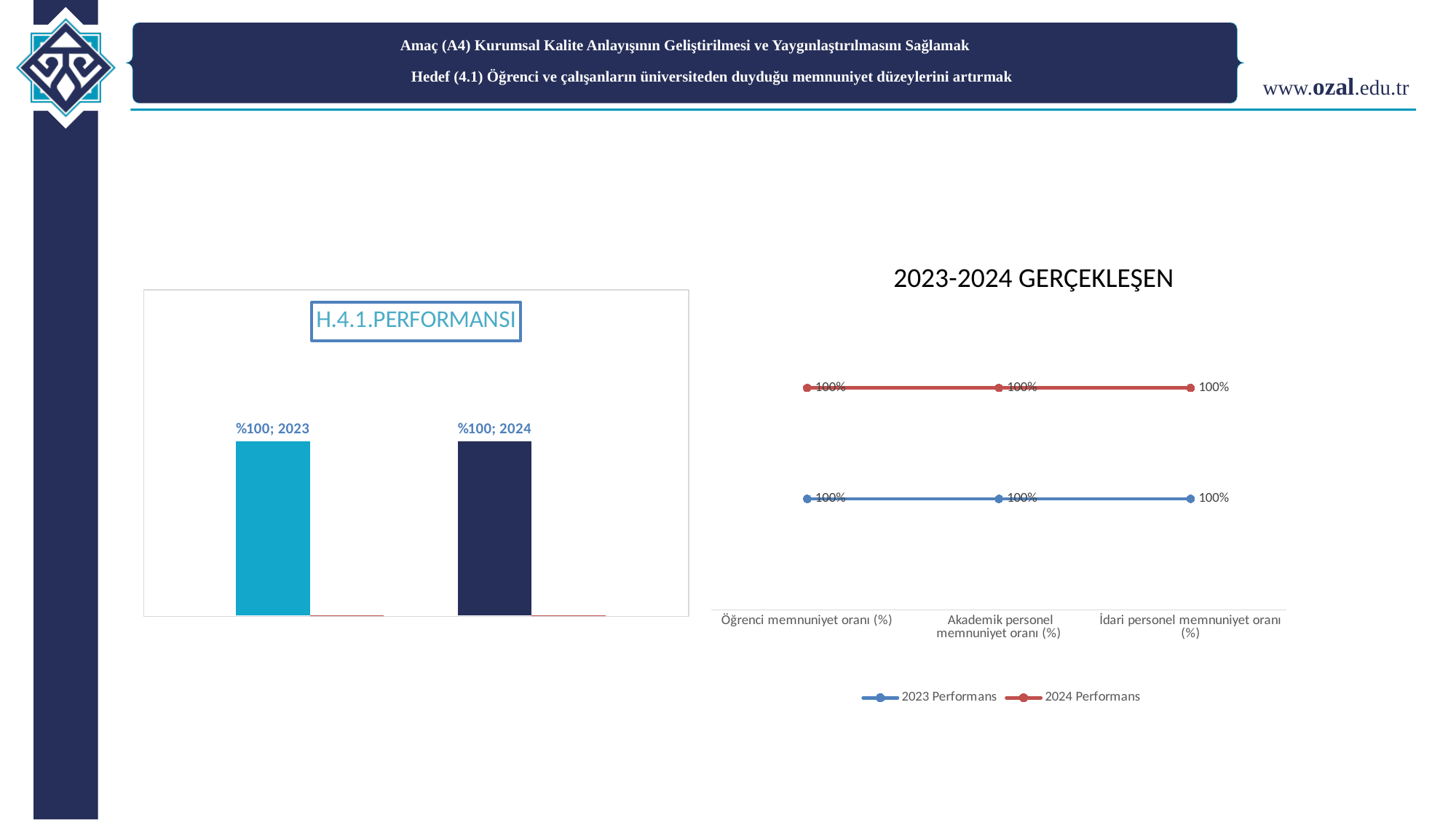
How many categories are shown on the x axis of the 2023-2024 GERÇEKLEŞEN chart? 3 In the H.4.1.PERFORMANSI chart, what is the difference between the 2024 and 2023 values? 0 In the 2023-2024 GERÇEKLEŞEN chart, do the 2023 Performans values rise, fall or stay flat across the categories? stay flat In the 2023-2024 GERÇEKLEŞEN chart, which series is drawn in red? 2024 Performans How many bars are shown in the H.4.1.PERFORMANSI chart? 2 How many series does the legend of the 2023-2024 GERÇEKLEŞEN chart list? 2 What kind of chart is the 2023-2024 GERÇEKLEŞEN chart on the right? line chart In the H.4.1.PERFORMANSI chart, what is the value for 2024? %100 In the 2023-2024 GERÇEKLEŞEN chart, what is the 2024 Performans value for Öğrenci memnuniyet oranı (%)? 100% In the H.4.1.PERFORMANSI chart, what is the value for 2023? %100 What kind of chart is the H.4.1.PERFORMANSI chart on the left? bar chart In the 2023-2024 GERÇEKLEŞEN chart, what is the 2023 Performans value for İdari personel memnuniyet oranı (%)? 100%